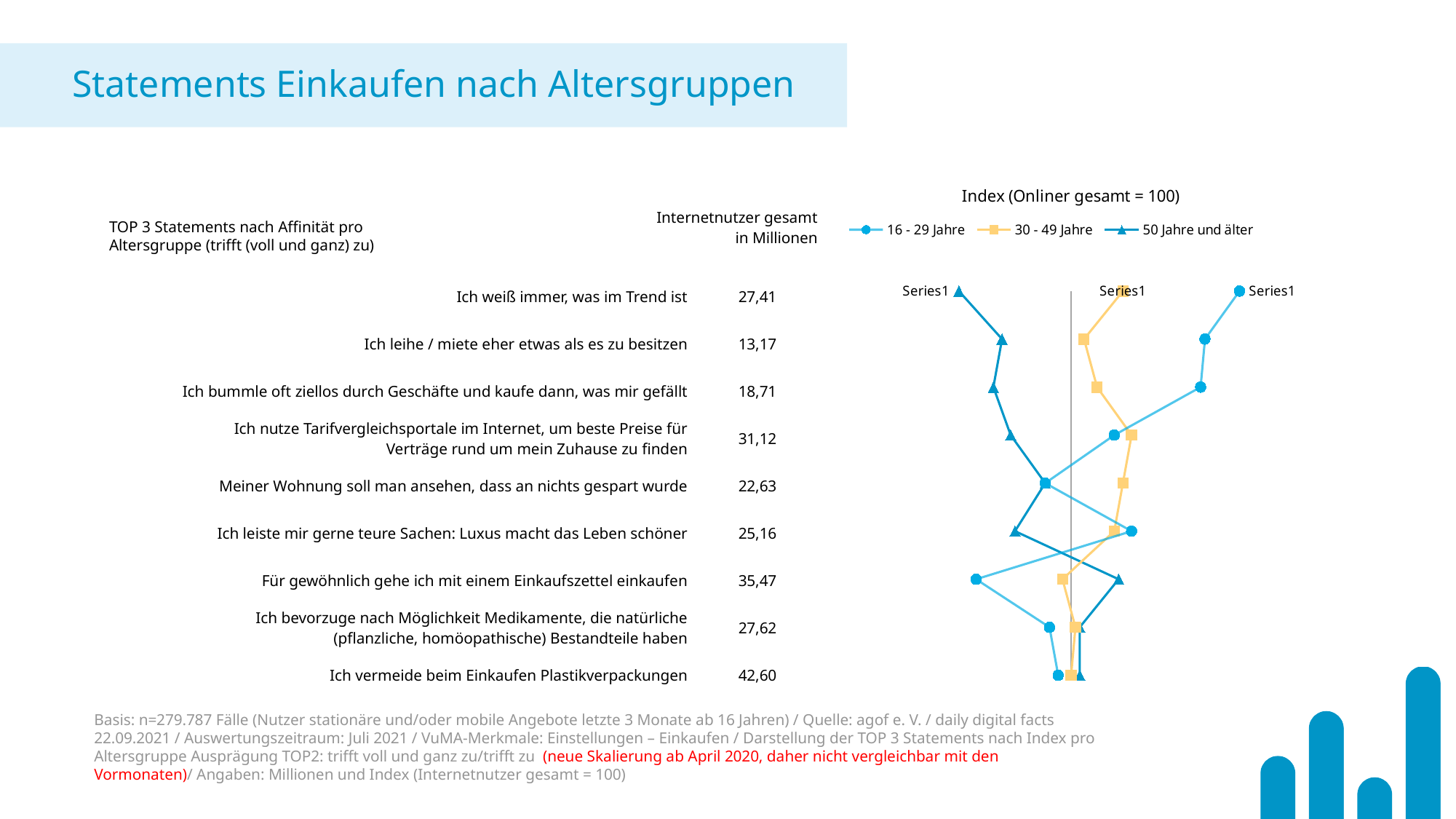
What is the title of the chart's index axis shown above the legend? Index (Onliner gesamt = 100) How many series does the chart legend list? 3 For 'Für gewöhnlich gehe ich mit einem Einkaufszettel einkaufen', which series has the higher index: '16 - 29 Jahre' or '50 Jahre und älter'? 50 Jahre und älter What is the value in millions (Internetnutzer gesamt) for 'Ich leihe / miete eher etwas als es zu besitzen'? 13,17 Is the index for '16 - 29 Jahre' on 'Ich weiß immer, was im Trend ist' greater or less than 100? greater Is the index for '50 Jahre und älter' on 'Ich weiß immer, was im Trend ist' greater or less than 100? less How many statements (categories) are plotted in the chart? 9 Which statement has the lowest value in millions (Internetnutzer gesamt)? Ich leihe / miete eher etwas als es zu besitzen What is the value in millions (Internetnutzer gesamt) for 'Ich vermeide beim Einkaufen Plastikverpackungen'? 42,60 What kind of chart is shown on the slide? line chart What is the difference in millions between 'Für gewöhnlich gehe ich mit einem Einkaufszettel einkaufen' and 'Ich nutze Tarifvergleichsportale im Internet, um beste Preise für Verträge rund um mein Zuhause zu finden'? 4,35 Which statement has the highest value in millions (Internetnutzer gesamt)? Ich vermeide beim Einkaufen Plastikverpackungen